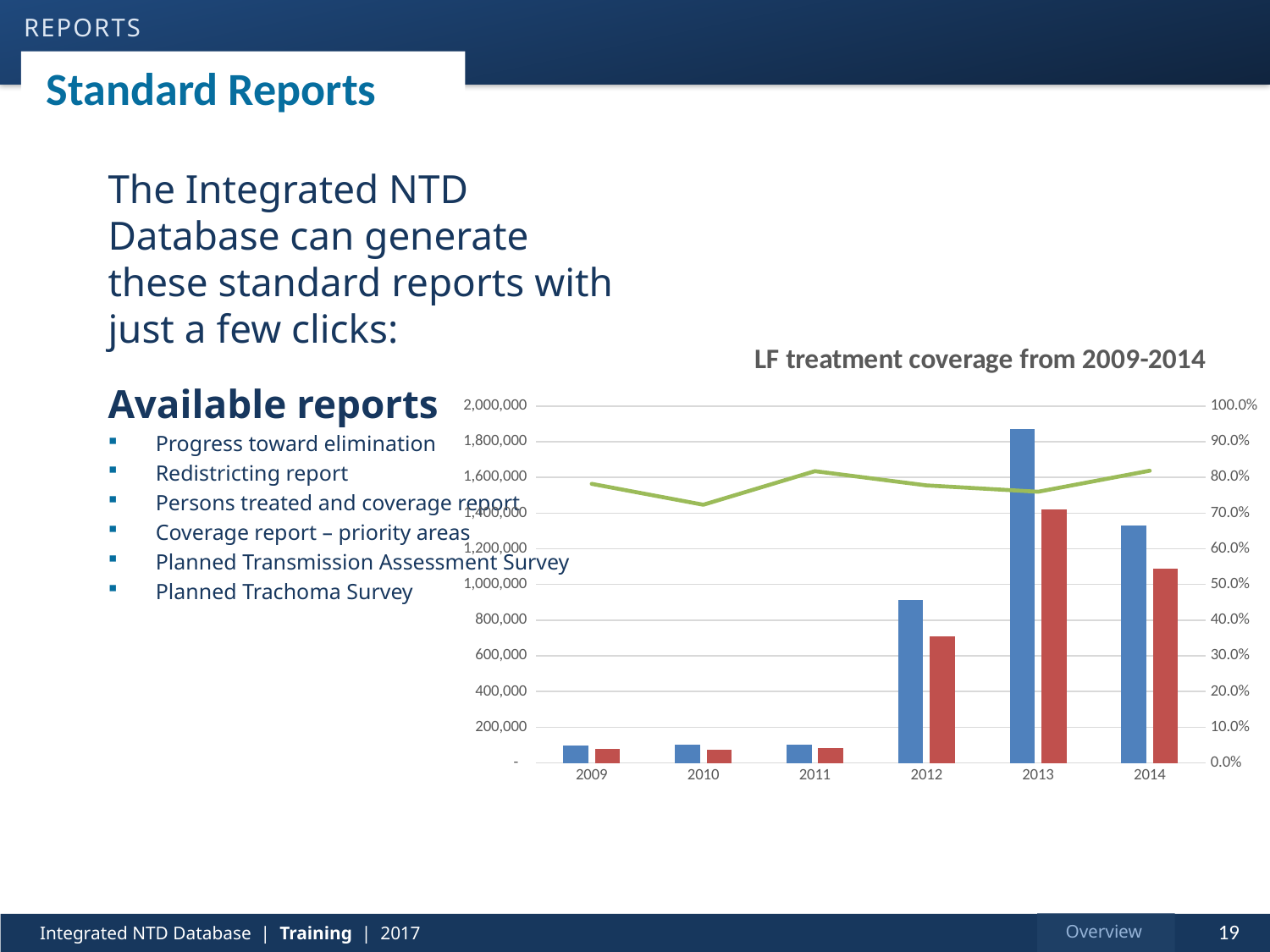
Is the red bar for 2012 greater or less than 600,000? greater Do the blue bars rise or fall from 2011 to 2013? rise What is the title of the chart on the slide? LF treatment coverage from 2009-2014 Which year has the tallest blue bar in the chart? 2013 Which year has the tallest red bar in the chart? 2013 What kind of chart is shown on the slide? Bar chart with a line How many years are shown on the x axis of the chart? 6 Is the blue bar for 2012 greater or less than 1,000,000? less Which is larger, the blue bar for 2013 or the blue bar for 2014? 2013 Is the blue bar for 2013 greater or less than 1,800,000? greater In which year is the green line at its lowest point? 2010